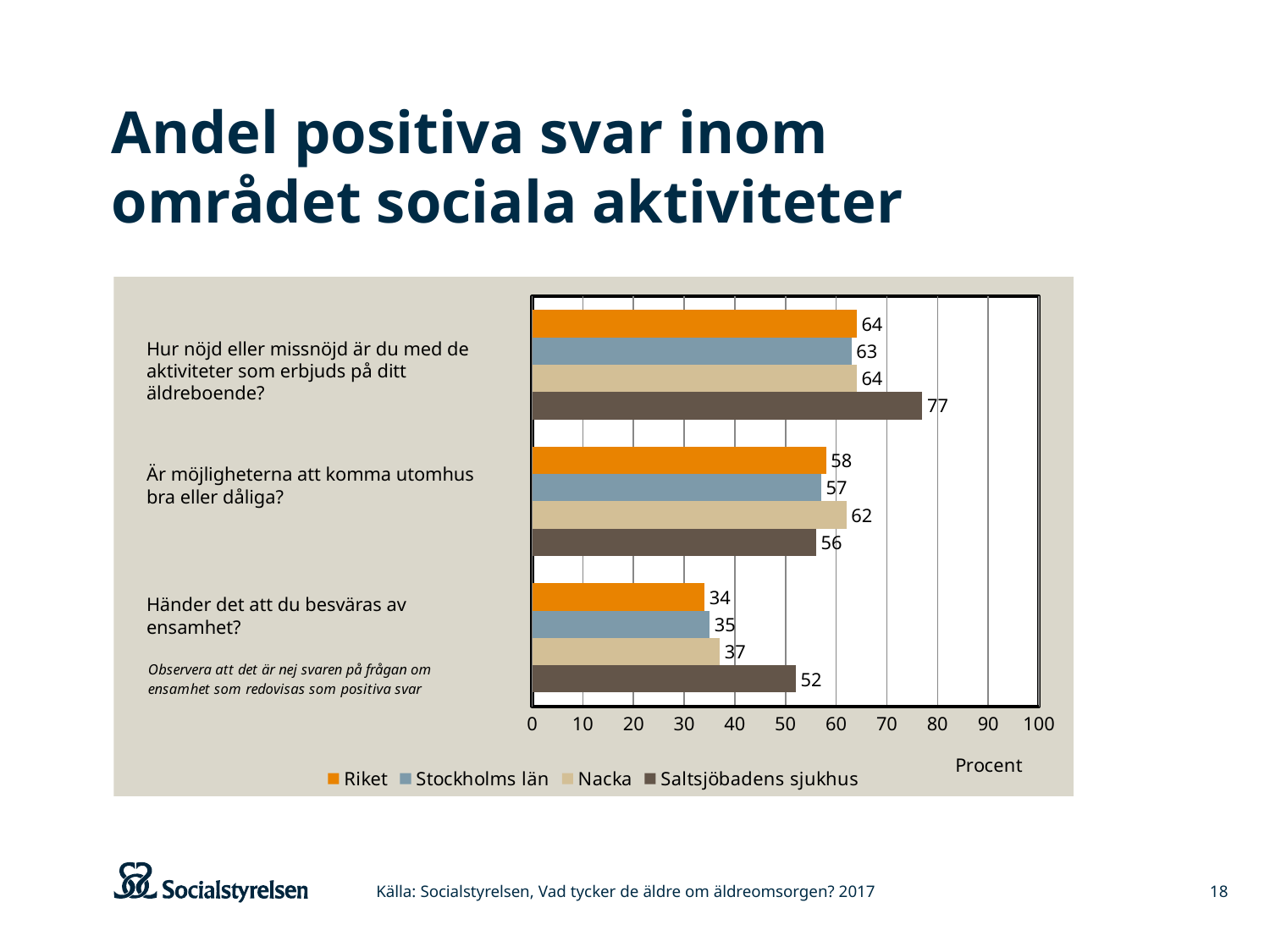
How many questions (categories) are shown on the chart? 3 What is the difference between the Saltsjöbadens sjukhus value and the Riket value on the question "Hur nöjd eller missnöjd är du med de aktiviteter som erbjuds på ditt äldreboende?"? 13 What value is shown for Saltsjöbadens sjukhus on the question "Hur nöjd eller missnöjd är du med de aktiviteter som erbjuds på ditt äldreboende?"? 77 Which series has the lowest value on the question "Är möjligheterna att komma utomhus bra eller dåliga?"? Saltsjöbadens sjukhus What value is shown for Nacka on the question "Är möjligheterna att komma utomhus bra eller dåliga?"? 62 How many series does the legend list? 4 Which is larger on the question "Händer det att du besväras av ensamhet?": the value for Nacka or the value for Saltsjöbadens sjukhus? Saltsjöbadens sjukhus Which series has the highest value on the question "Händer det att du besväras av ensamhet?"? Saltsjöbadens sjukhus What value is shown for Riket on the question "Händer det att du besväras av ensamhet?"? 34 Is the value for Saltsjöbadens sjukhus on the question "Hur nöjd eller missnöjd är du med de aktiviteter som erbjuds på ditt äldreboende?" greater or less than 70? greater What value is shown for Stockholms län on the question "Hur nöjd eller missnöjd är du med de aktiviteter som erbjuds på ditt äldreboende?"? 63 What kind of chart is shown on the slide? Bar chart